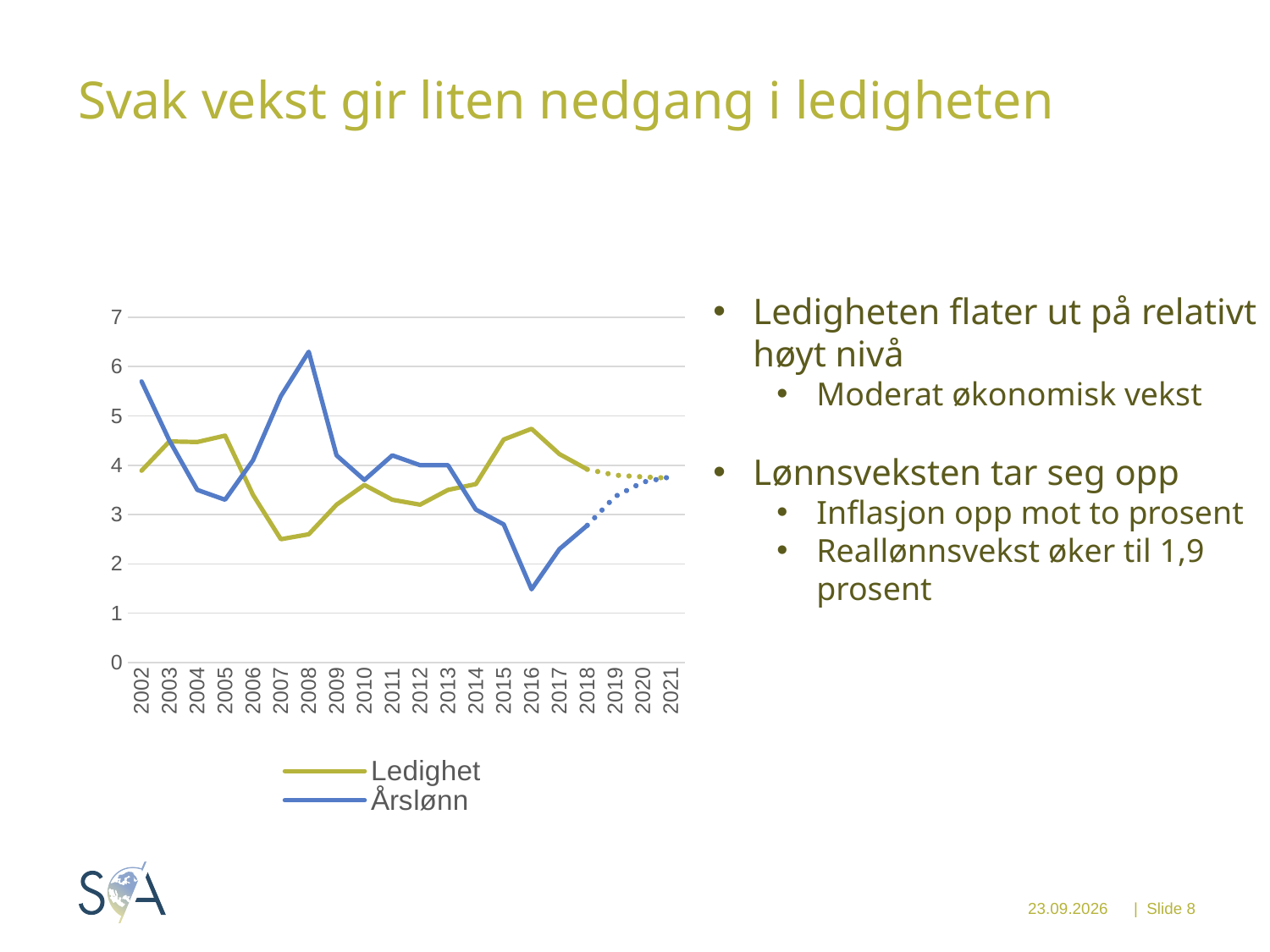
In which year does the Ledighet series reach its lowest value? 2007 In which year does the Årslønn series reach its highest value? 2008 In 2016, which series has the larger value, Ledighet or Årslønn? Ledighet How many years are shown on the x axis of the chart? 20 How many series does the chart legend list? 2 Which two series are listed in the chart legend? Ledighet and Årslønn Is the value for Årslønn in 2016 greater or less than 2? less Is the value for Årslønn in 2008 greater or less than 6? greater What kind of chart is shown on the slide? line chart Is the value for Ledighet in 2007 greater or less than 3? less In which year does the Årslønn series reach its lowest value? 2016 Does the Årslønn series rise or fall from 2016 to 2021? rise